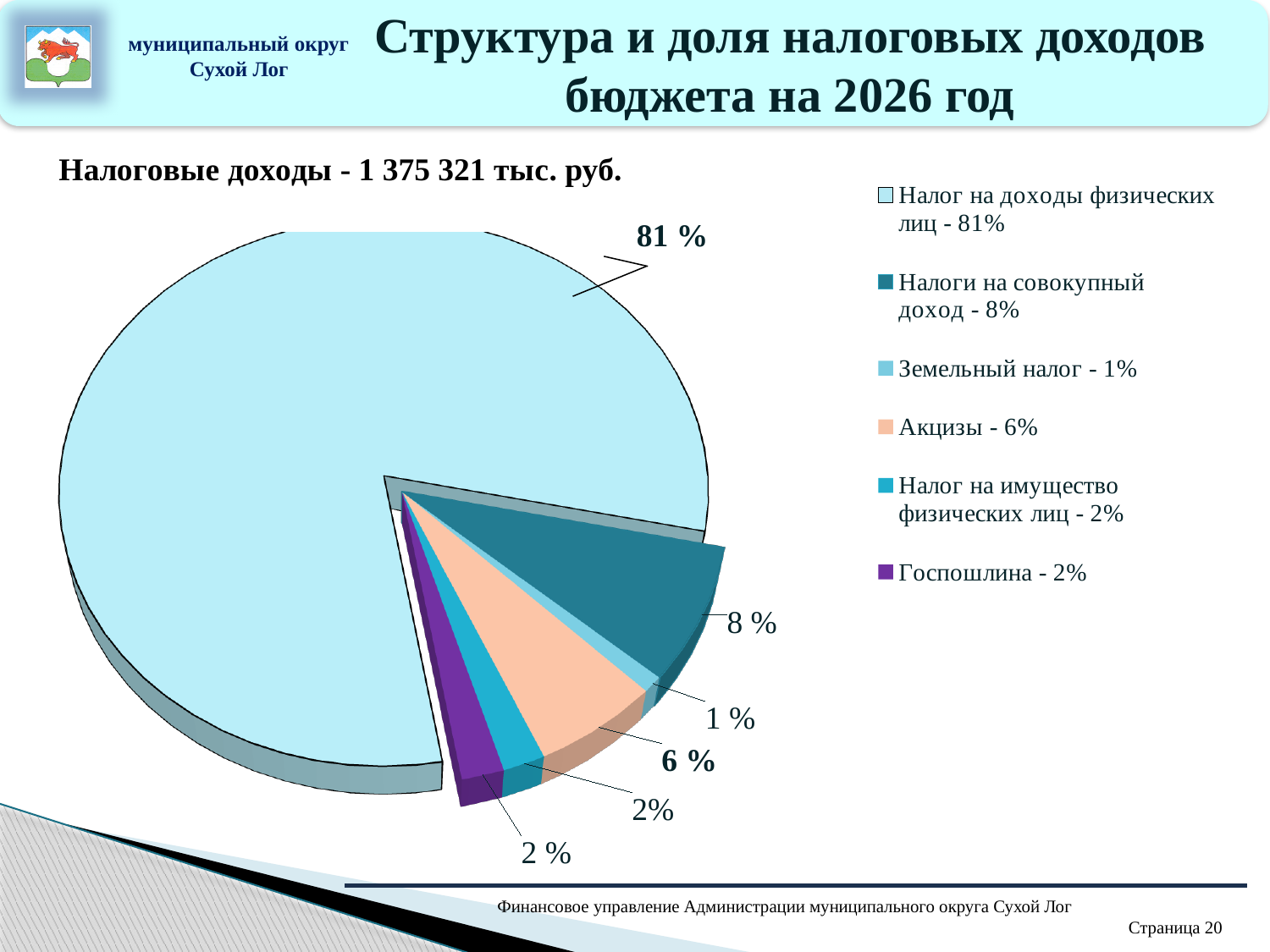
How many slices does the pie chart have? 6 What share of tax revenues does "Госпошлина" account for? 2% What share of tax revenues does "Земельный налог" account for? 1% What kind of chart is shown on the slide? pie chart Which category has the largest slice of the pie? Налог на доходы физических лиц What total amount of tax revenues is stated above the chart? 1 375 321 тыс. руб. What share of tax revenues does "Налоги на совокупный доход" account for? 8% What is the difference in percentage points between the share of "Налоги на совокупный доход" and the share of "Акцизы"? 2 Which is larger: the share of "Налоги на совокупный доход" or the share of "Акцизы"? Налоги на совокупный доход Which category has the smallest slice of the pie? Земельный налог